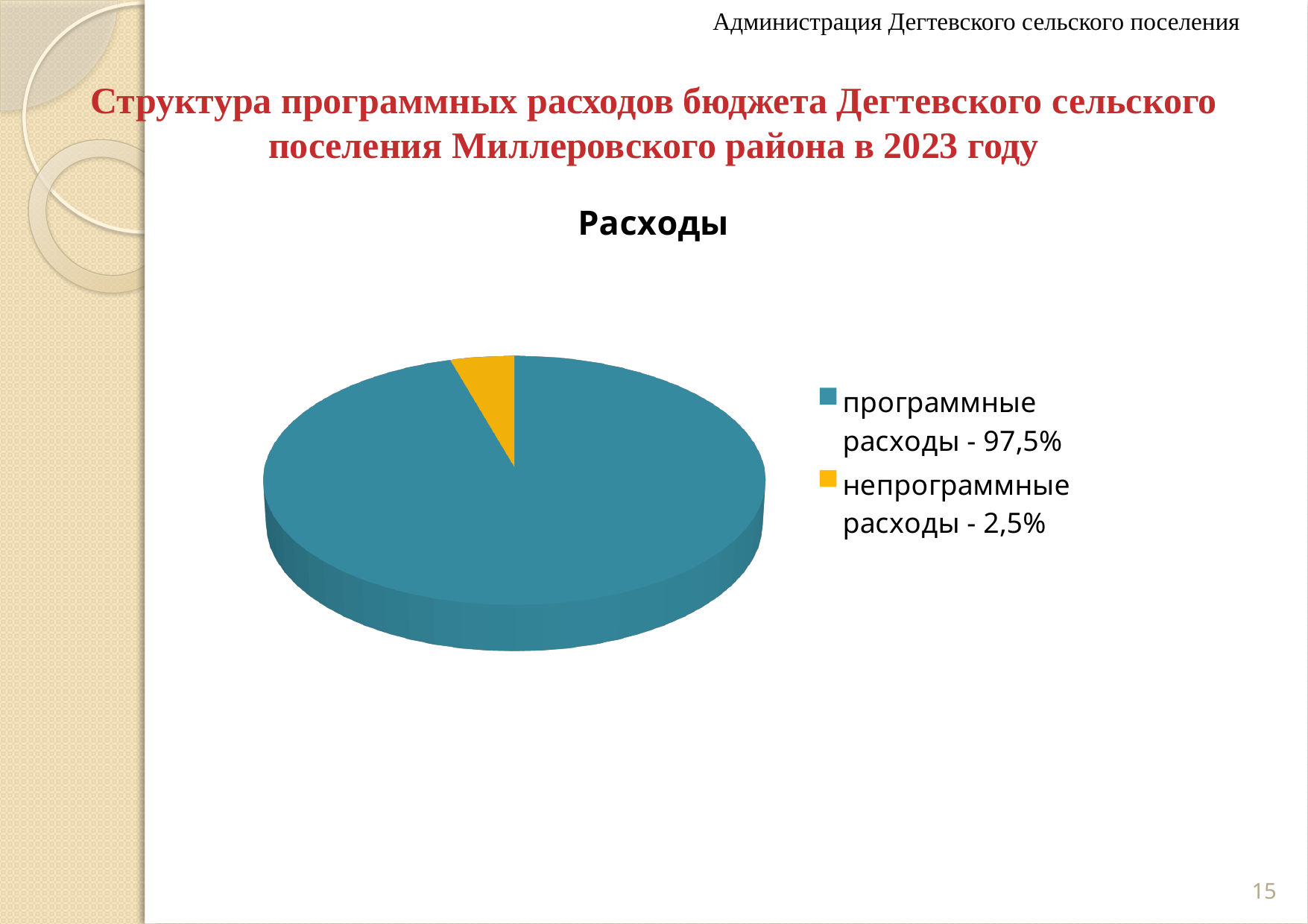
What share of the pie is 'программные расходы'? 97,5% What is the difference in percentage points between 'программные расходы' and 'непрограммные расходы'? 95 Which is larger: 'программные расходы' or 'непрограммные расходы'? программные расходы What colour is the slice for 'непрограммные расходы'? yellow How many entries does the legend list? 2 Which category has the largest slice? программные расходы What share of the pie is 'непрограммные расходы'? 2,5% How many slices does the pie chart have? 2 Which category has the smallest slice? непрограммные расходы What is the title of the chart? Расходы What kind of chart is shown on the slide? pie chart